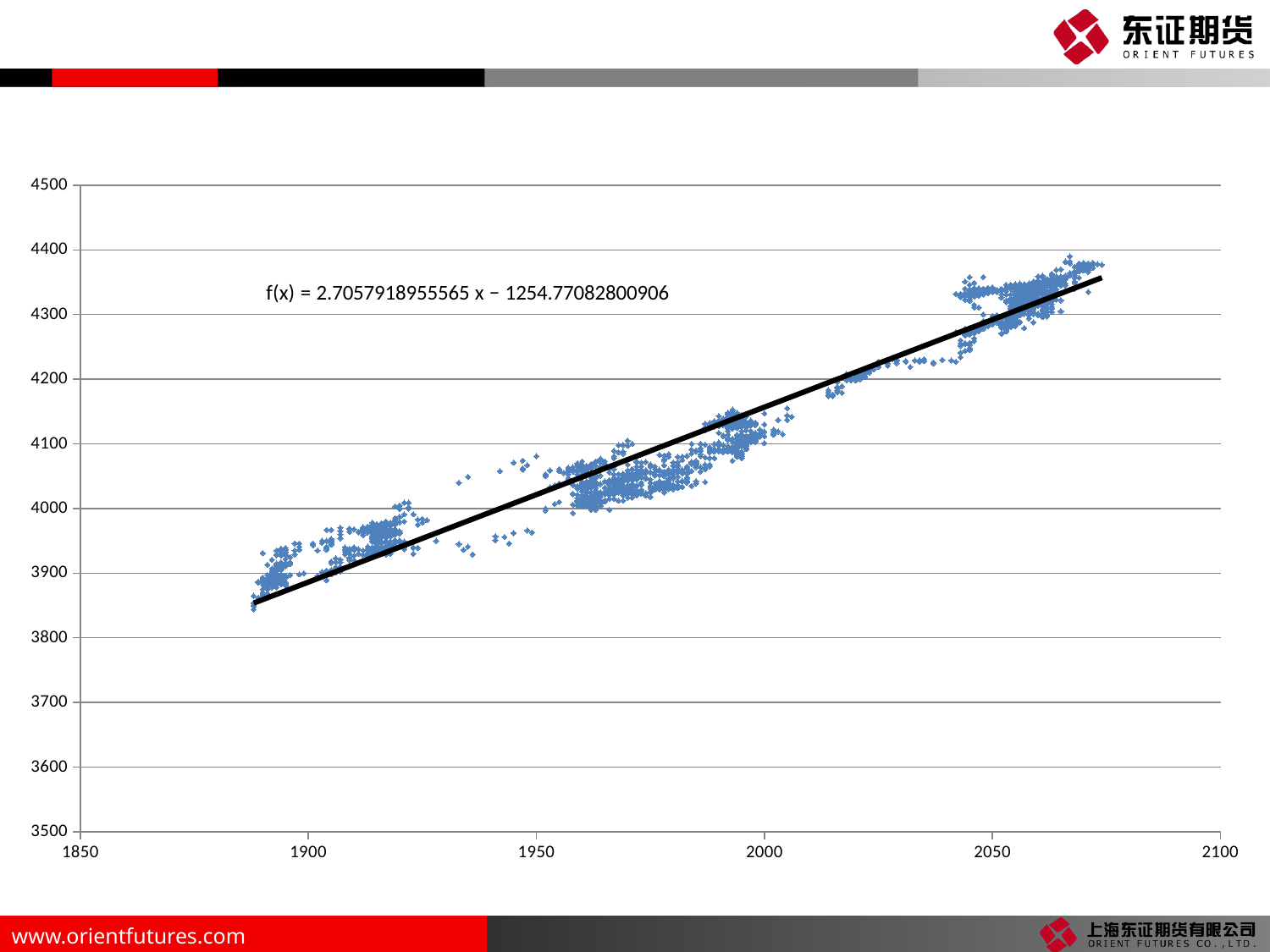
Is the value of the fitted line at x = 2000 greater or less than 4100? greater Do the plotted points generally rise or fall as the x-axis value increases? rise What is the slope of the fitted line shown in the equation on the chart? 2.7057918955565 What is the intercept of the fitted line shown in the equation on the chart? −1254.77082800906 Is the value of the fitted line at x = 2050 greater or less than 4200? greater Is the value of the fitted line at x = 2000 greater or less than 4200? less What kind of chart is shown on the slide? scatter chart Are the plotted points near x = 2050 higher or lower on the y-axis than the points near x = 1900? higher